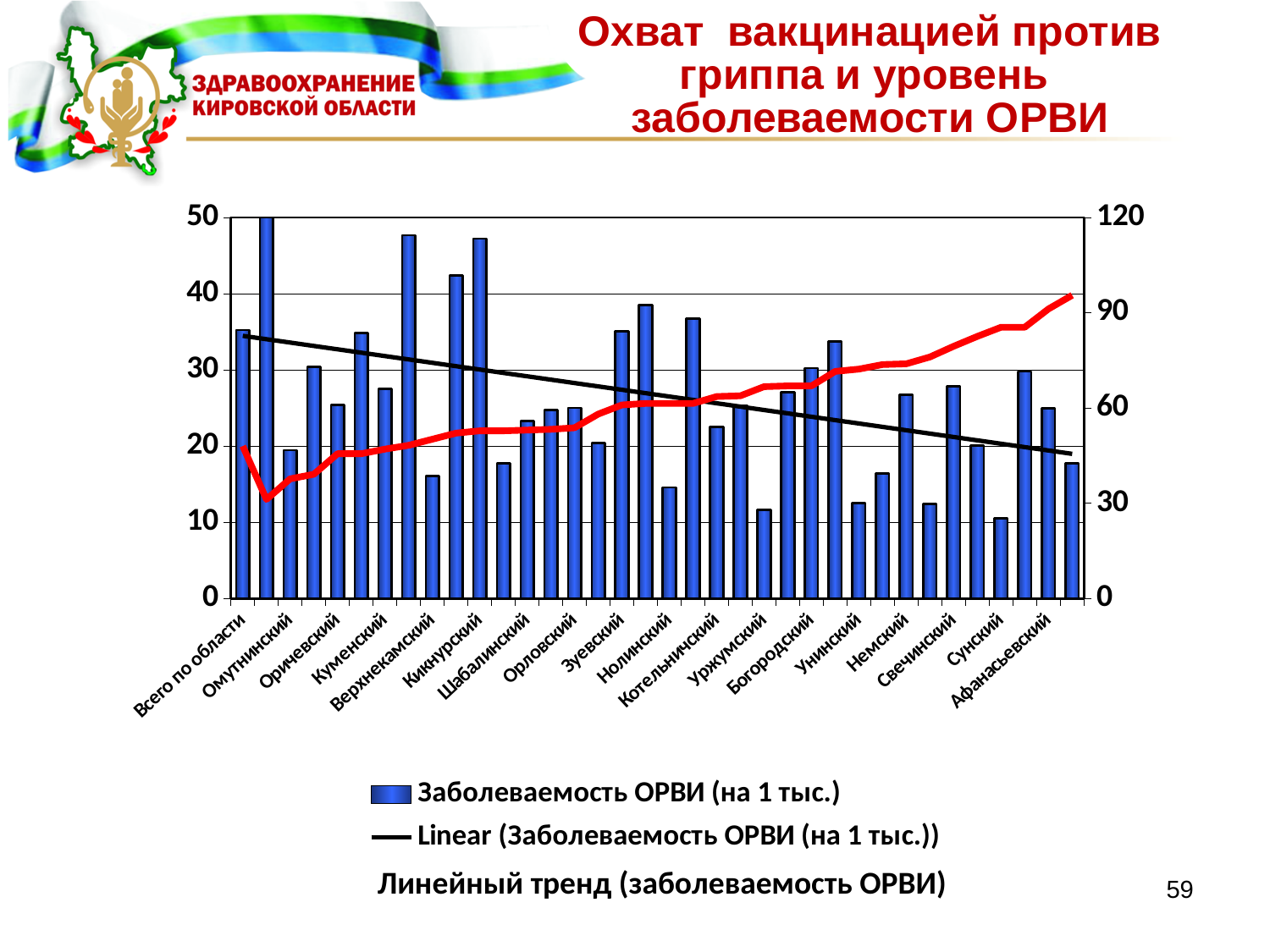
Is the value for Зуевский greater or less than 30? greater What is the first entry in the legend? Заболеваемость ОРВИ (на 1 тыс.) How many series does the legend list? 2 Does the black linear trend line rise or fall from left to right? Falls Which has the higher bar, Зуевский or Нолинский? Зуевский What kind of chart is shown on the slide? Bar chart with a line Is the value for Кикнурский greater or less than 40? greater Is the value for Всего по области greater or less than 30? greater Which has the higher bar, Кикнурский or Сунский? Кикнурский